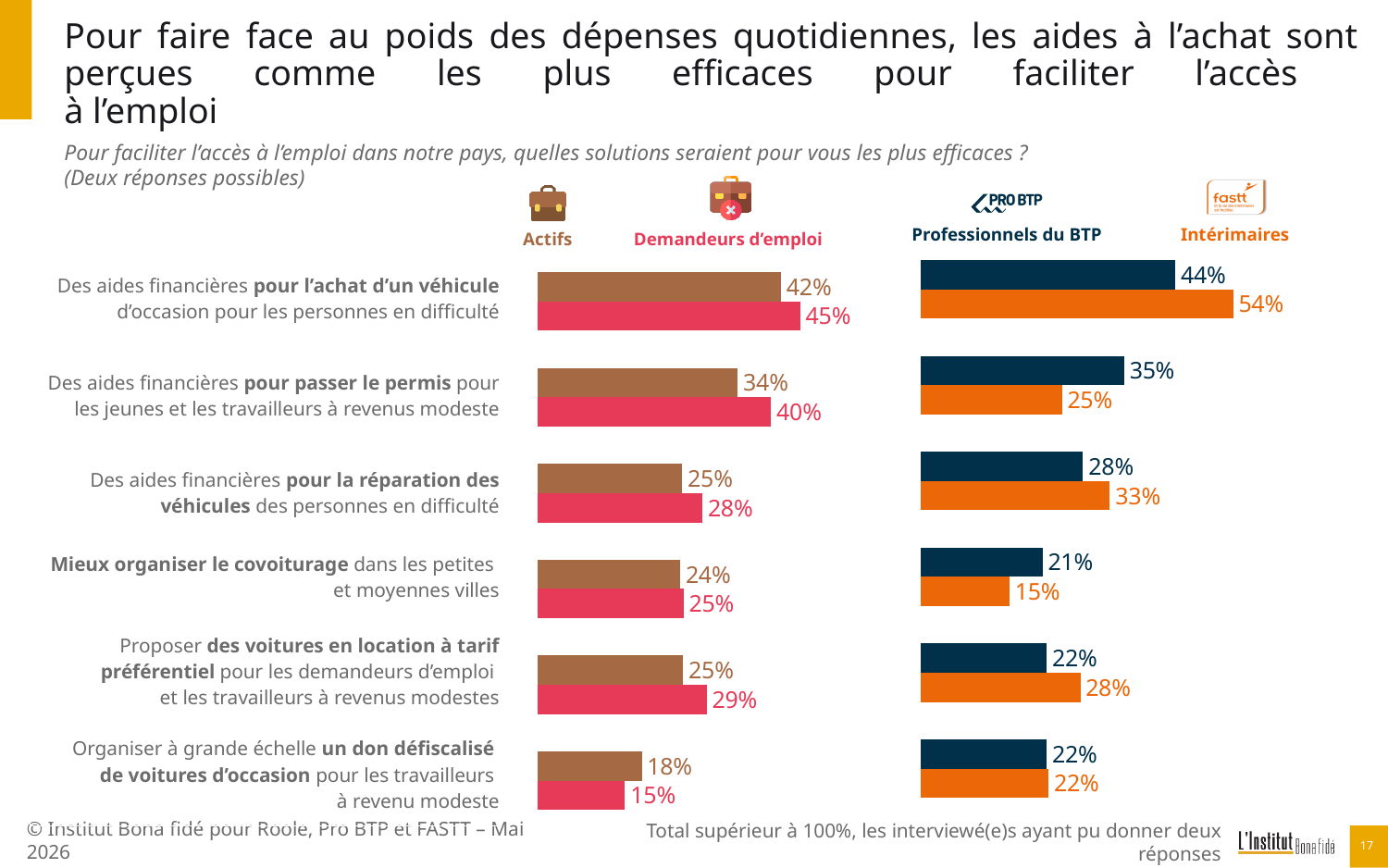
On the left chart, what is the value for Demandeurs d'emploi for 'Des aides financières pour l'achat d'un véhicule d'occasion pour les personnes en difficulté'? 45% How many categories are shown on the left chart? 6 On the left chart, which category has the lowest value for Demandeurs d'emploi? Organiser à grande échelle un don défiscalisé de voitures d'occasion pour les travailleurs à revenu modeste On the left chart, which is larger for 'Mieux organiser le covoiturage dans les petites et moyennes villes': Actifs or Demandeurs d'emploi? Demandeurs d'emploi On the right chart, what is the value for Intérimaires for 'Des aides financières pour l'achat d'un véhicule d'occasion pour les personnes en difficulté'? 54% On the right chart, which is larger for 'Mieux organiser le covoiturage dans les petites et moyennes villes': Professionnels du BTP or Intérimaires? Professionnels du BTP What type of chart is used on the left side of the slide? Bar chart On the left chart, what is the value for Actifs for 'Des aides financières pour passer le permis pour les jeunes et les travailleurs à revenus modeste'? 34% On the right chart, what is the difference between Intérimaires and Professionnels du BTP for 'Des aides financières pour passer le permis'? 10% On the right chart, what is the difference between Intérimaires and Professionnels du BTP for 'Des aides financières pour la réparation des véhicules des personnes en difficulté'? 5% How many series does the right chart show? 2 On the right chart, which category has the highest value for Professionnels du BTP? Des aides financières pour l'achat d'un véhicule d'occasion pour les personnes en difficulté